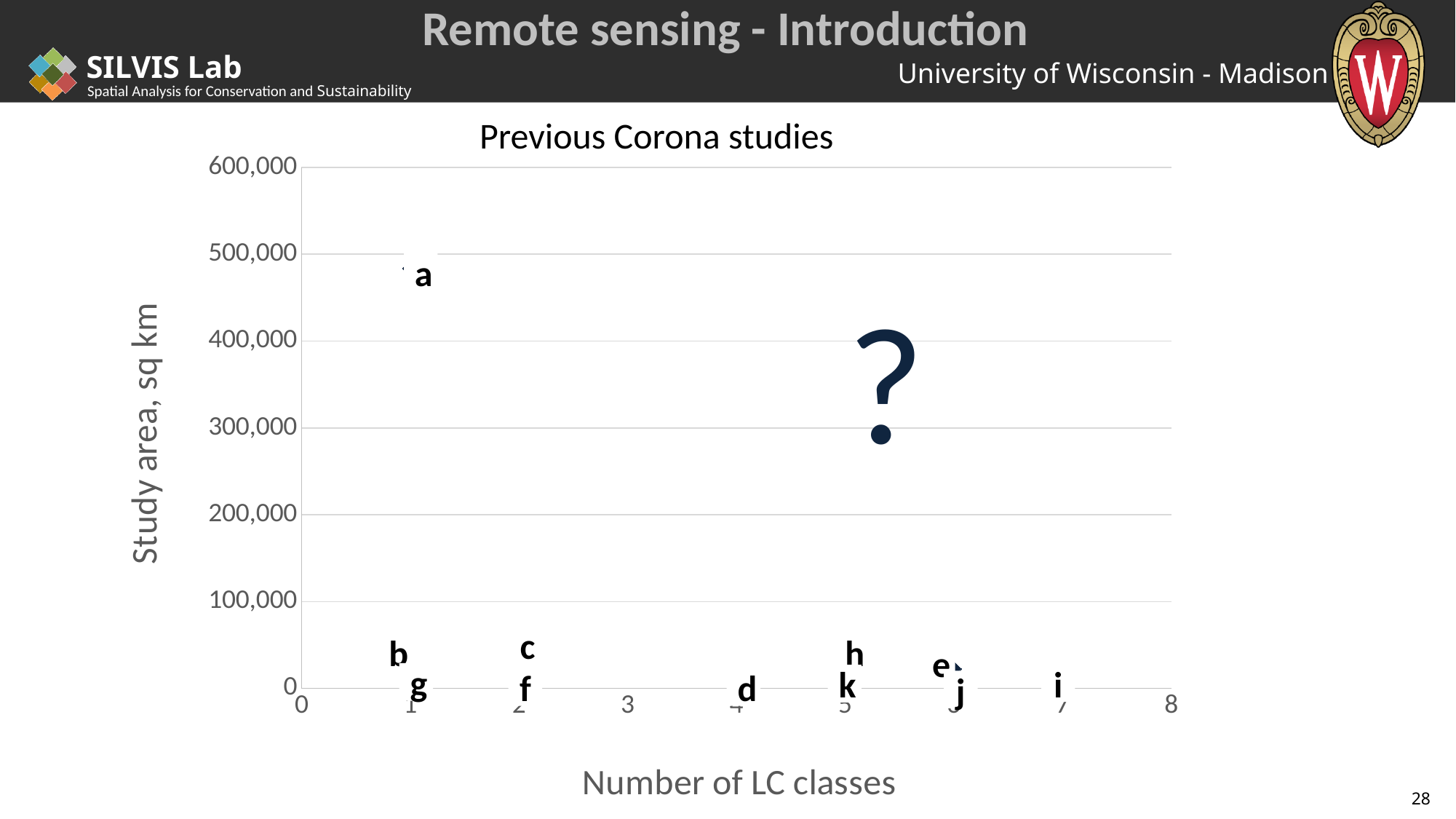
What is the highest value shown on the y axis of the chart? 600,000 Which has the larger study area, point a or point c? a Is the study area for point a greater or less than 400,000 sq km? greater What is the title of the chart? Previous Corona studies What kind of chart is shown on the slide? scatter chart How many lettered points are plotted on the chart? 11 Which has the larger study area, the point marked with a question mark or point h? the point marked with a question mark Is the study area for the point marked with a question mark greater or less than 400,000 sq km? less What is the label of the y axis of the chart? Study area, sq km Is the study area for point b greater or less than 100,000 sq km? less Which lettered point has the largest study area? a